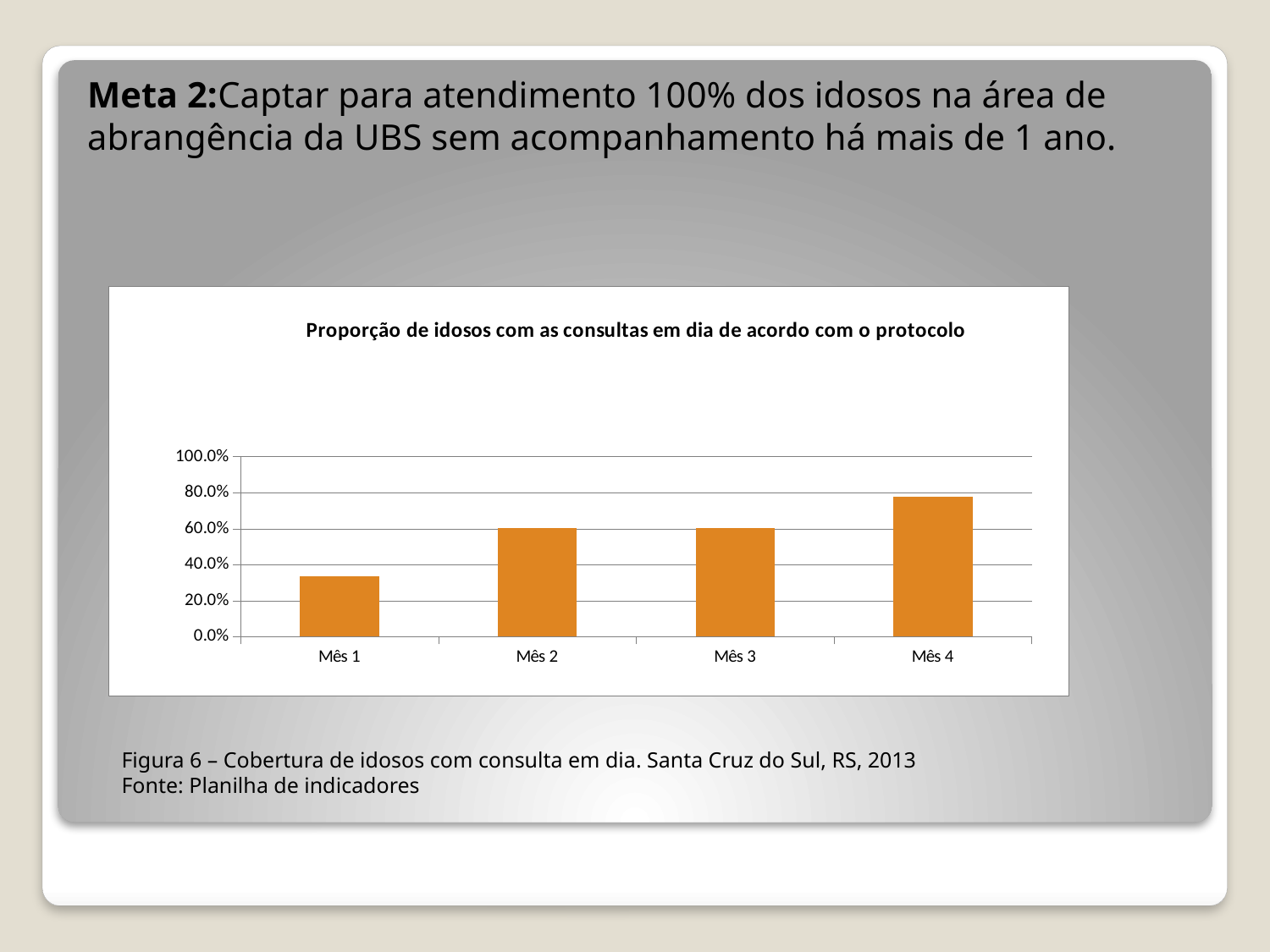
Which month has the highest proportion in the chart? Mês 4 Is the value for Mês 1 greater or less than 40.0%? less Is the value for Mês 4 greater or less than 60.0%? greater Which is larger, the value for Mês 1 or the value for Mês 2? Mês 2 What type of chart is shown on the slide? bar chart Which is larger, the value for Mês 1 or the value for Mês 4? Mês 4 How many months (categories) are shown on the x axis of the chart? 4 What is the title of the chart? Proporção de idosos com as consultas em dia de acordo com o protocolo Which month has the lowest proportion in the chart? Mês 1 Overall, do the values rise or fall from Mês 1 to Mês 4? rise Is the value for Mês 4 greater or less than 100.0%? less